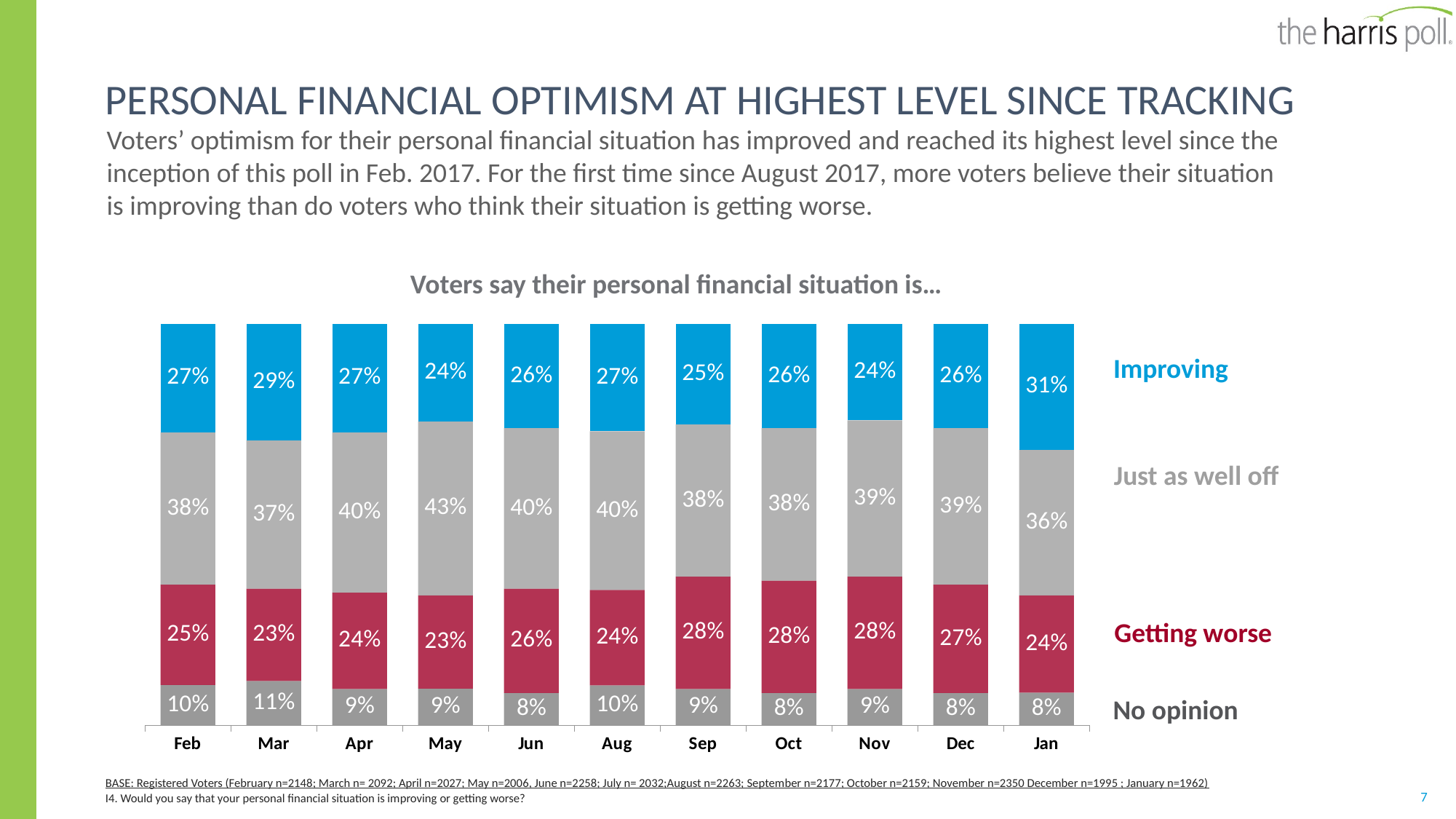
How many response categories (series) does the chart show? 4 In which month was the 'Just as well off' share lowest? Jan What is the title of the chart? Voters say their personal financial situation is... What kind of chart is shown on the slide? Stacked bar chart What percentage of voters said their personal financial situation was improving in Jan? 31% How many months are shown along the x axis of the chart? 11 What percentage of voters said they were just as well off in May? 43% What percentage of voters said their situation was getting worse in Sep? 28% In Jan, how many percentage points higher is 'Improving' than 'Getting worse'? 7 Which is larger in Oct: the 'Getting worse' share or the 'Improving' share? Getting worse In which month was the 'Improving' share highest? Jan What percentage of voters had no opinion in Mar? 11%